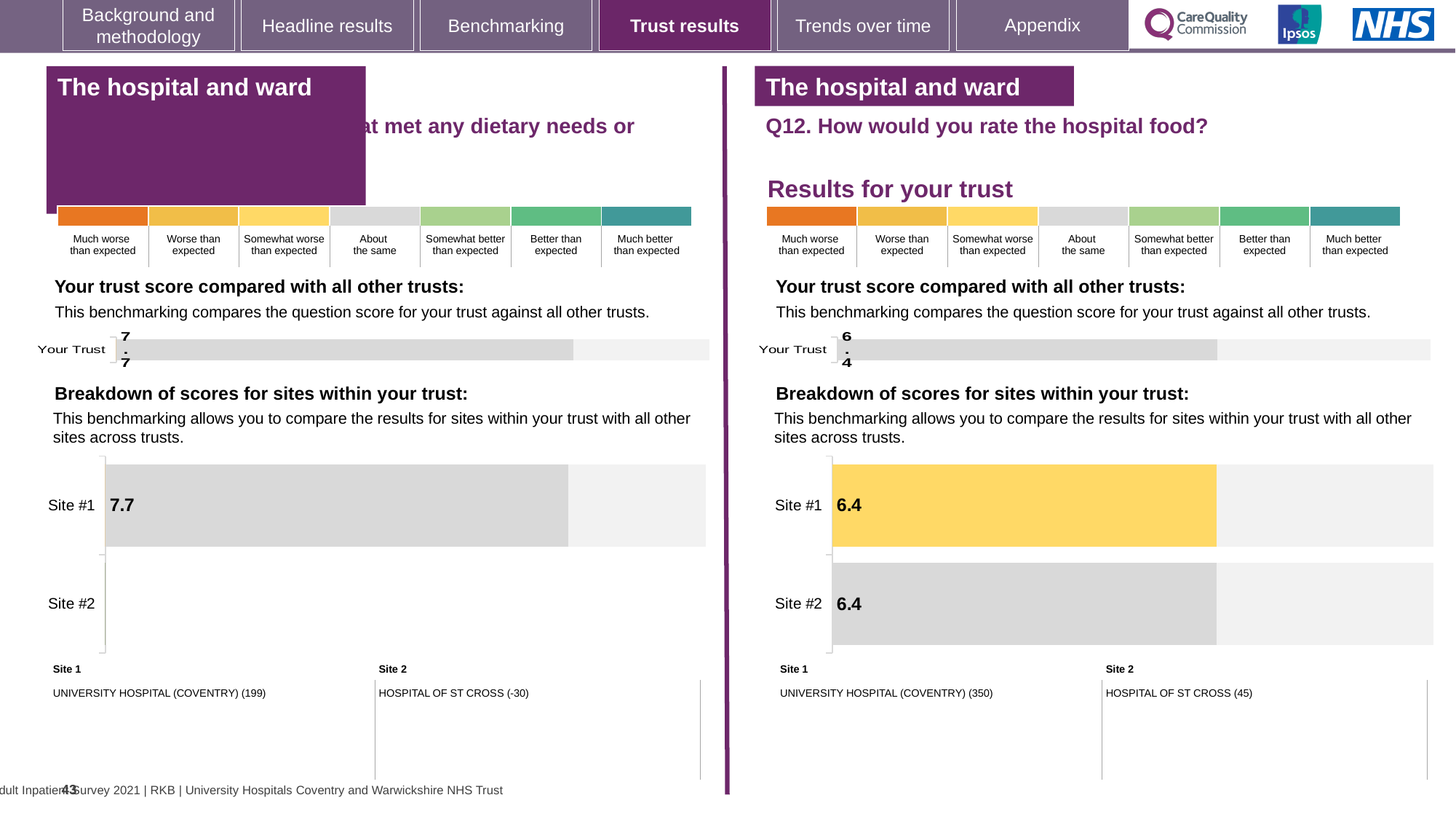
On the Q12 hospital food site breakdown chart, do Site #1 and Site #2 have the same score? Yes, both are 6.4 What type of chart is used to show the site breakdown of scores on the Q12 hospital food chart? Bar chart According to the site key under the Q12 hospital food chart, which hospital is Site 1? UNIVERSITY HOSPITAL (COVENTRY) On the left-hand site breakdown chart (dietary needs question), what is the score for Site #1? 7.7 What is the difference between the Your Trust score on the left-hand chart (7.7) and the Your Trust score on the Q12 hospital food chart (6.4)? 1.3 On the Q12 hospital food chart, what is the score shown for Your Trust? 6.4 On the left-hand chart (dietary needs question), what is the score shown for Your Trust? 7.7 On the Q12 hospital food site breakdown chart, what colour is the bar for Site #1? Yellow Which is higher: the Your Trust score on the left-hand chart or the Your Trust score on the Q12 hospital food chart? The left-hand chart (7.7) On the Q12 hospital food site breakdown chart, what is the score for Site #2? 6.4 How many sites are listed on the Q12 hospital food site breakdown chart? 2 On the Q12 hospital food site breakdown chart, what is the score for Site #1? 6.4